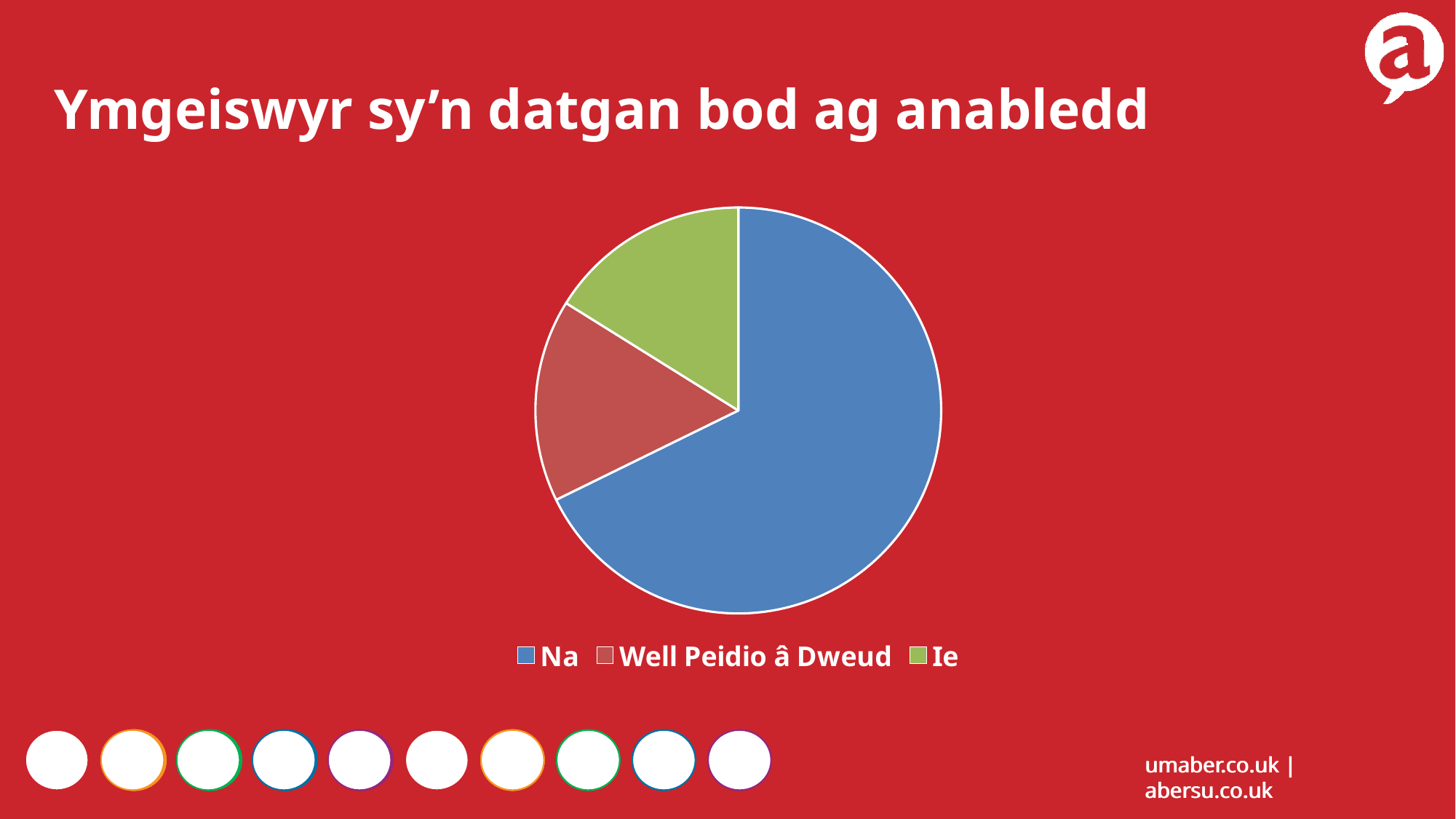
Which slice is larger, Na or Ie? Na What kind of chart is shown on the slide? pie chart What is the title of the slide containing the pie chart? Ymgeiswyr sy’n datgan bod ag anabledd Which colour represents the category Ie in the pie chart? green How many entries does the legend of the pie chart list? 3 How many slices does the pie chart have? 3 Which category has the largest slice of the pie chart? Na Which slice is larger, Na or Well Peidio â Dweud? Na